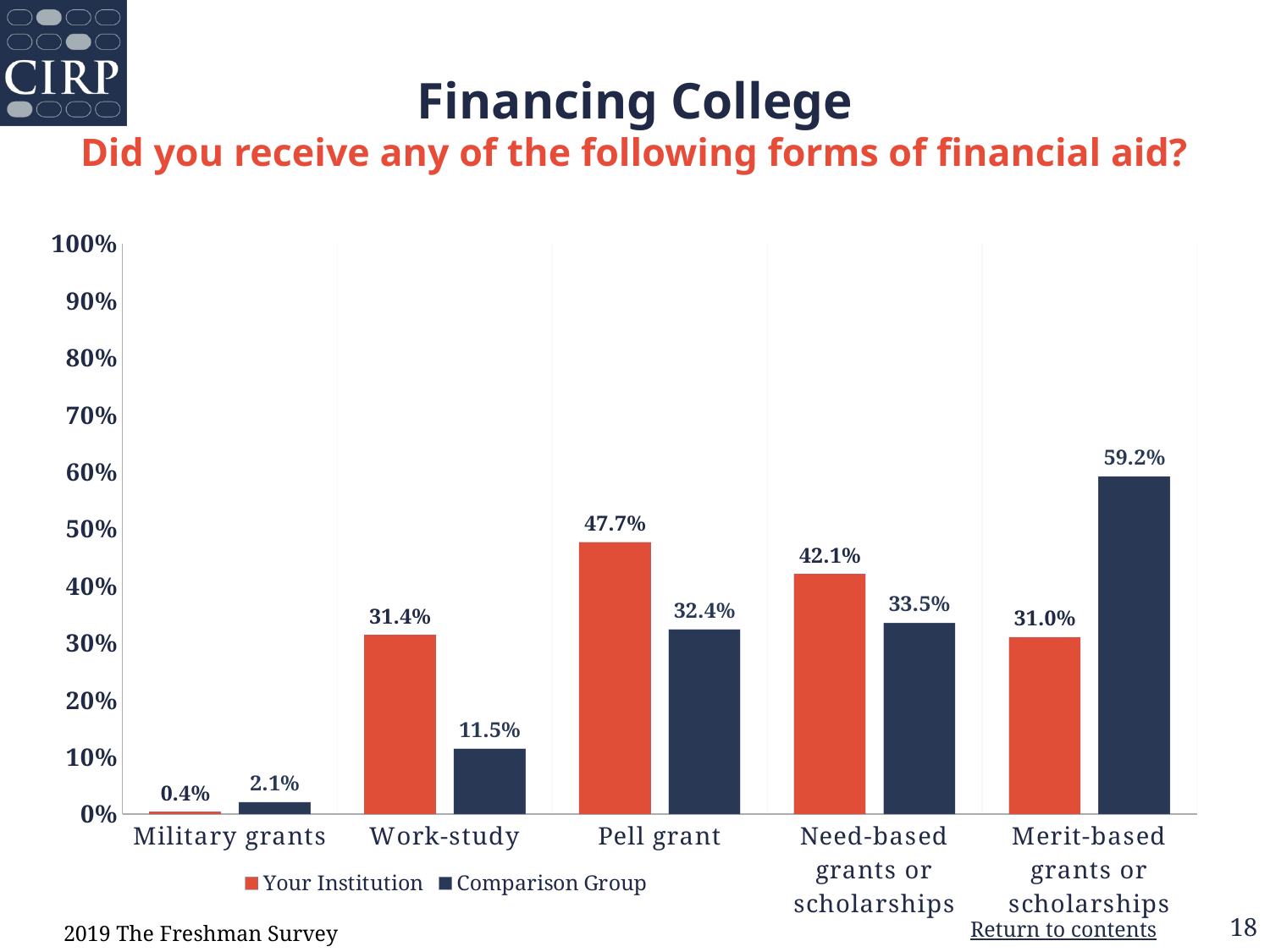
What is the Comparison Group value for Merit-based grants or scholarships? 59.2% Which category has the lowest value for Your Institution? Military grants For Need-based grants or scholarships, which is larger: Your Institution or the Comparison Group? Your Institution What is the Your Institution value for Work-study? 31.4% What percentage of Your Institution students received a Pell grant? 47.7% How many series does the legend list? 2 How many categories of financial aid are shown on the x axis? 5 What kind of chart is shown on the slide? Bar chart Which category has the highest value for the Comparison Group? Merit-based grants or scholarships Is the Comparison Group value for Pell grant greater or less than 40%? less What colour are the bars for the Comparison Group? Dark navy blue What is the difference between Your Institution and the Comparison Group for Work-study? 19.9%